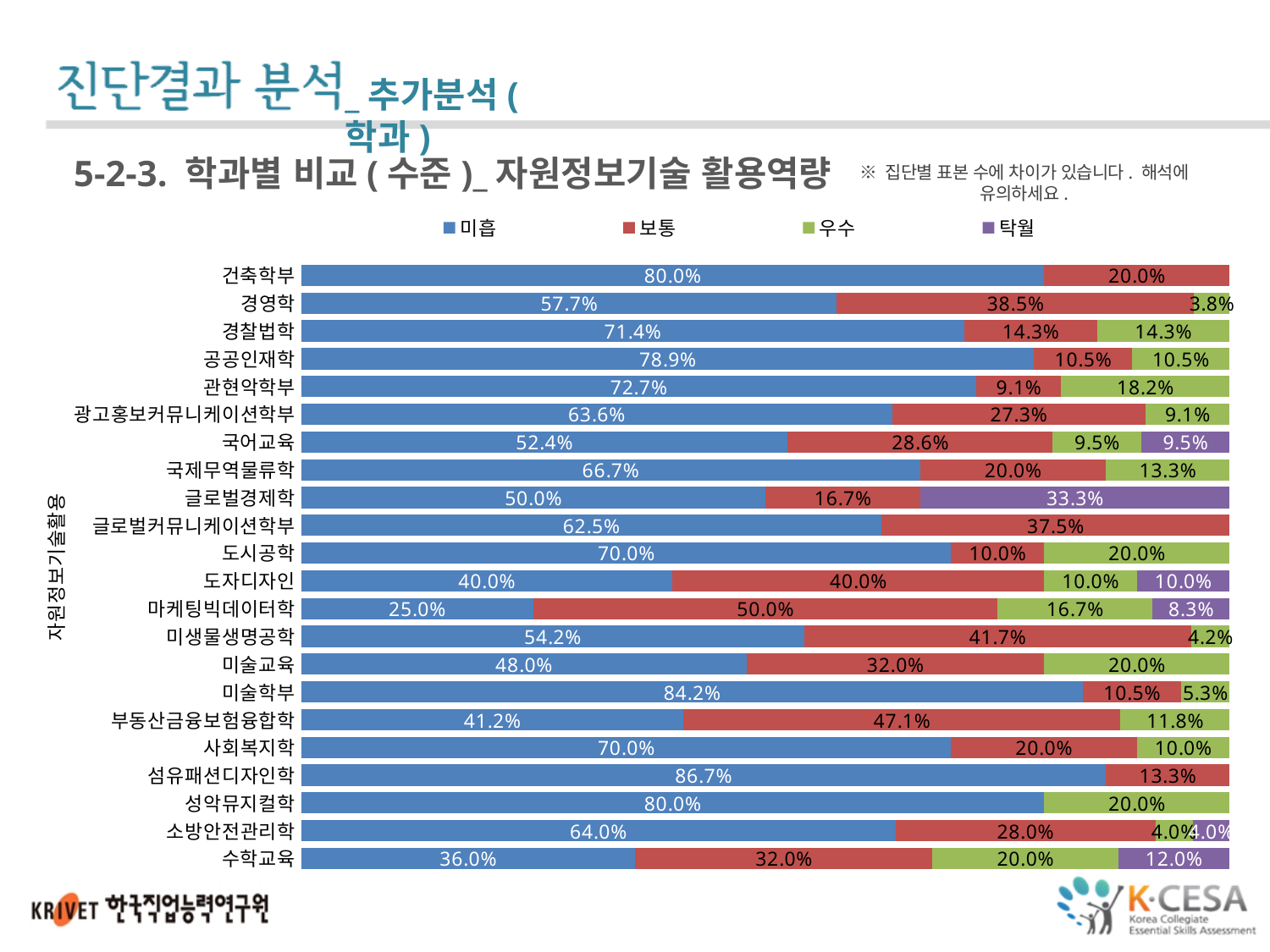
How many departments (categories) are plotted in the chart? 22 Which department has the highest 미흡 value? 섬유패션디자인학 Which series is shown in purple in the legend? 탁월 Which department has the lowest 미흡 value? 마케팅빅데이터학 What is the 보통 value for 마케팅빅데이터학? 50.0% What is the 미흡 value for 섬유패션디자인학? 86.7% What type of chart is shown on the slide? Stacked bar chart What is the difference between the 미흡 values of 건축학부 and 수학교육? 44.0% Which has a larger 보통 value, 부동산금융보험융합학 or 미술교육? 부동산금융보험융합학 How many series does the legend list? 4 What is the 우수 value for 관현악학부? 18.2% What is the 탁월 value for 글로벌경제학? 33.3%